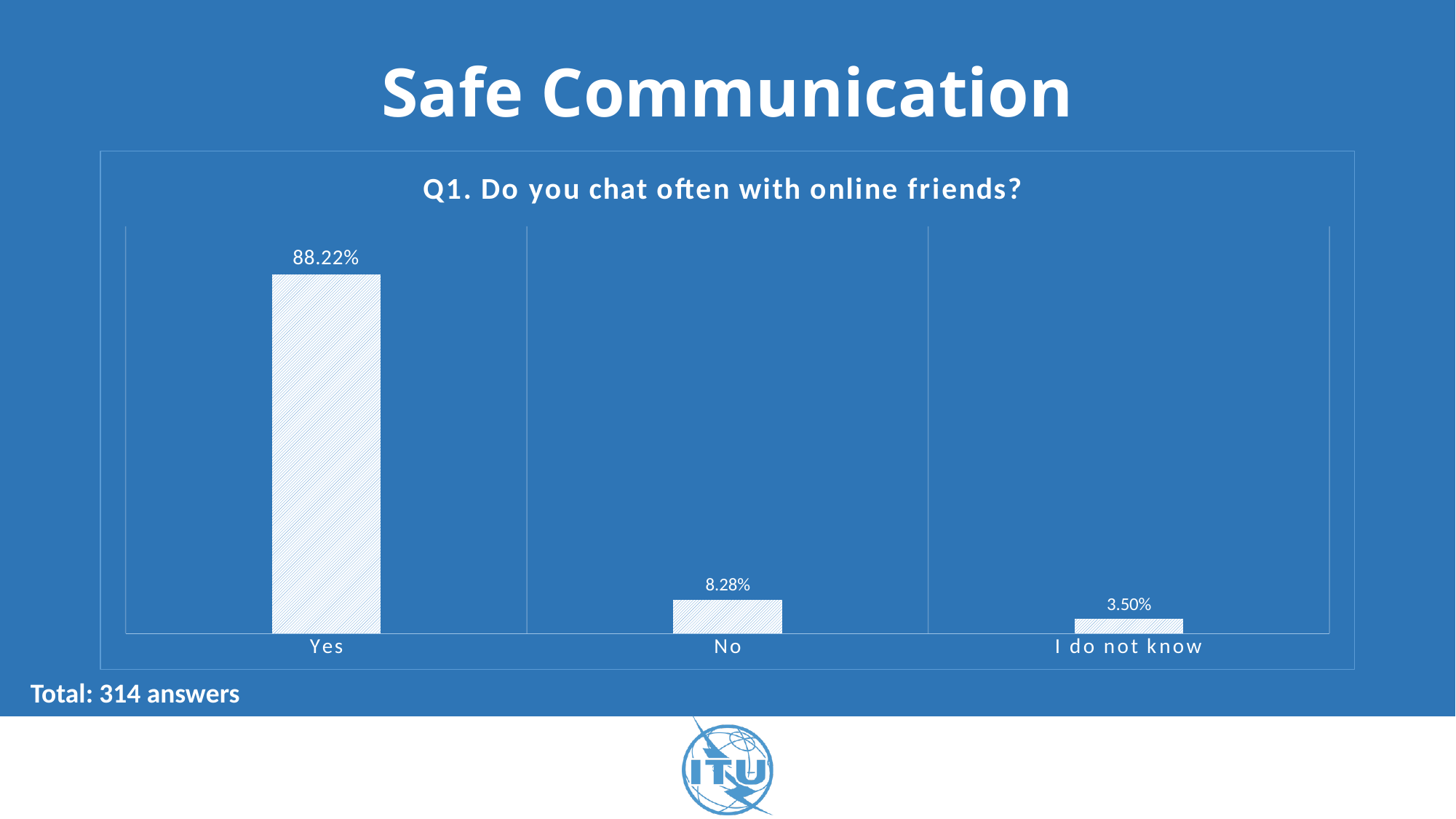
What is the difference in percentage points between the "Yes" and "No" answers? 79.94 Which answer category has the lowest percentage? I do not know What percentage of respondents answered "I do not know" to Q1? 3.50% Do the values rise or fall moving from left to right across the categories? Fall How many answer categories are shown in the chart? 3 What percentage of respondents answered "No" to Q1? 8.28% What kind of chart is shown on the slide? Bar chart Which answer category has the highest percentage? Yes What percentage of respondents answered "Yes" to Q1? 88.22% What is the title of the chart? Q1. Do you chat often with online friends? Which is larger, the percentage for "No" or for "I do not know"? No What is the difference in percentage points between the "No" and "I do not know" answers? 4.78